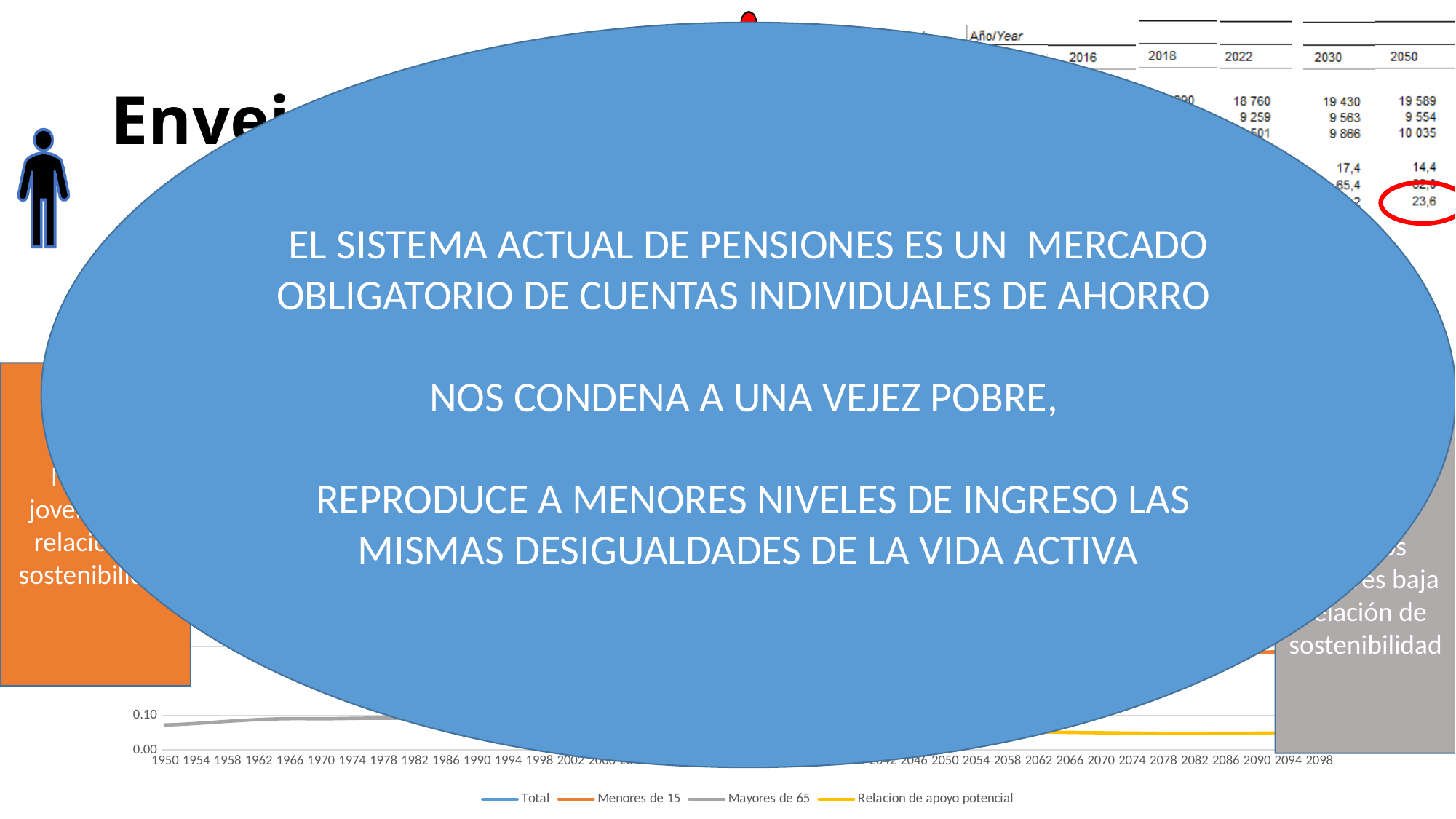
How many series does the legend of the line chart list? 4 Which series in the line chart's legend is shown in yellow? Relacion de apoyo potencial What is the first year shown on the x axis of the line chart? 1950 What kind of chart is shown at the bottom of the slide? line chart Which series in the line chart's legend is shown in blue? Total Is the value of the Mayores de 65 series in 1950 greater or less than 0.10? less What is the last year shown on the x axis of the line chart? 2098